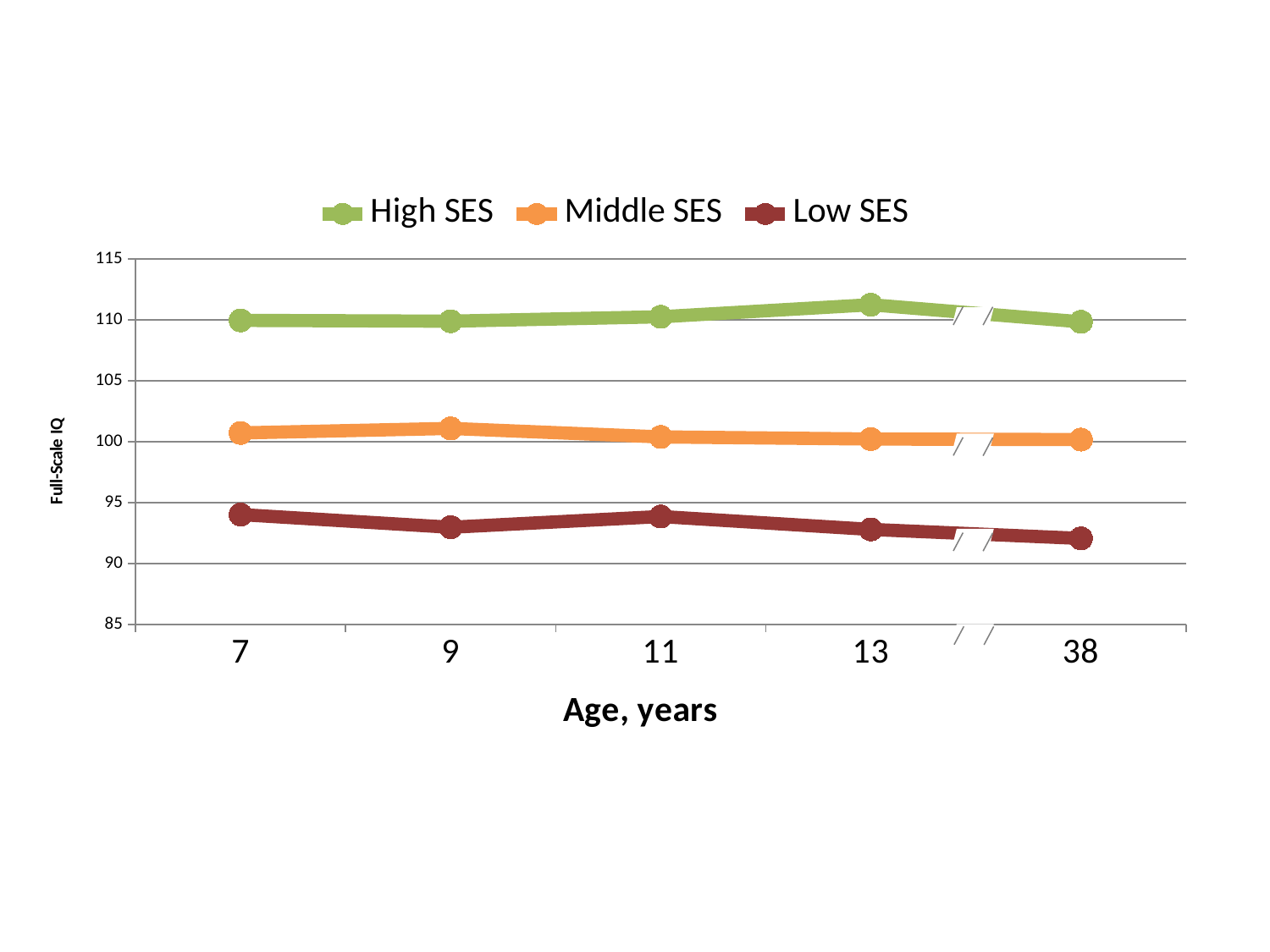
Does the Low SES series rise or fall between age 13 and age 38? Fall Which series has the lowest Full-Scale IQ values across all ages? Low SES Which is larger at age 38, the Middle SES value or the Low SES value? Middle SES Is the High SES value at age 13 greater or less than 110? greater How many series does the legend list? 3 What is the title of the y axis? Full-Scale IQ What kind of chart is shown on the slide? Line chart How many age points are plotted along the x axis? 5 Is the Middle SES value at age 9 greater or less than 100? greater Which series has the highest Full-Scale IQ values across all ages? High SES At which age does the High SES series reach its highest value? 13 Is the Low SES value at age 7 greater or less than 95? less